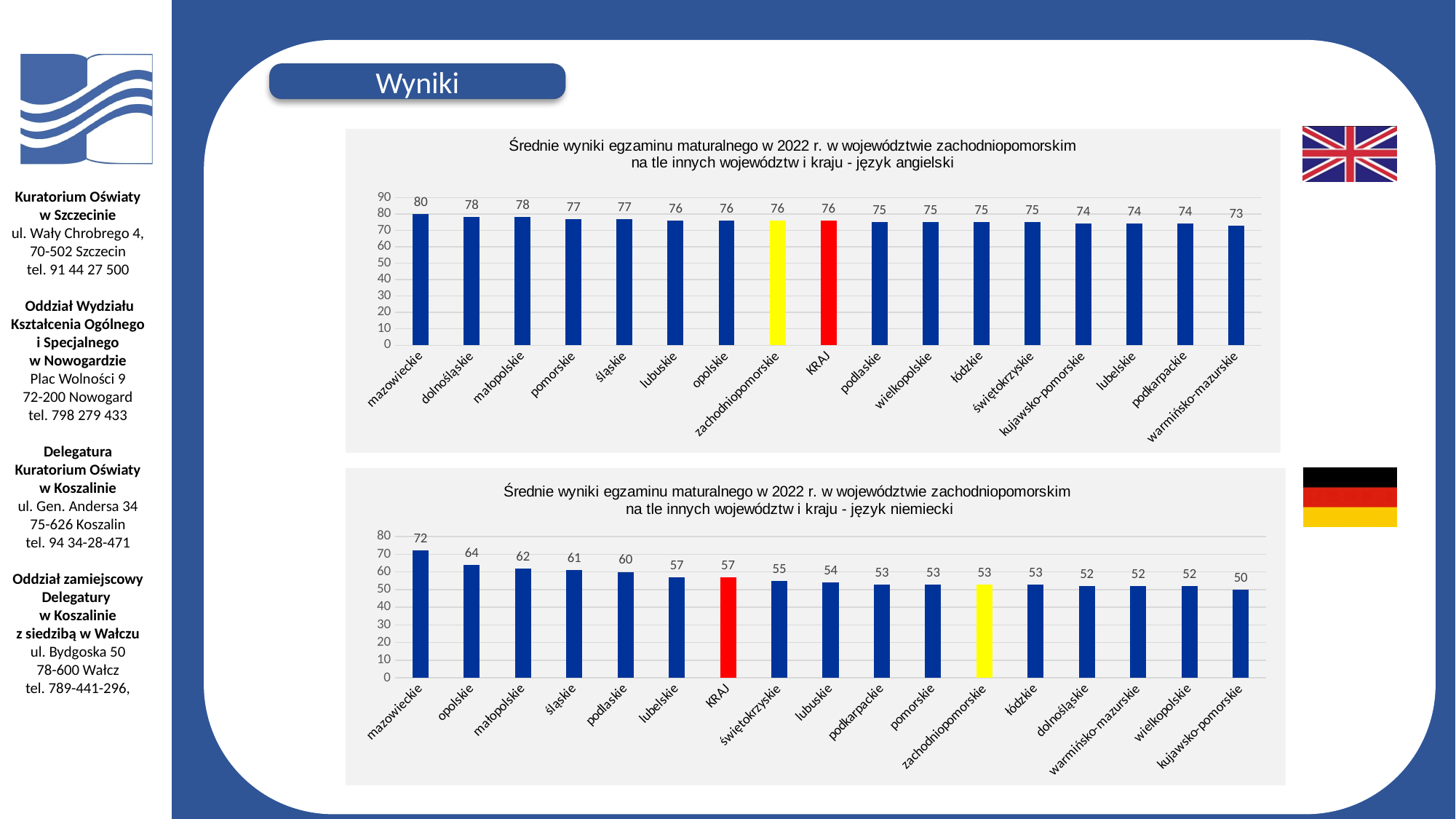
In the top chart (język angielski), what is the value for mazowieckie? 80 In the bottom chart (język niemiecki), what is the value for kujawsko-pomorskie? 50 In the top chart (język angielski), what is the difference between mazowieckie and warmińsko-mazurskie? 7 In the bottom chart (język niemiecki), what colour is the bar for zachodniopomorskie? yellow In the top chart (język angielski), what is the value for zachodniopomorskie? 76 In the bottom chart (język niemiecki), what is the value for KRAJ? 57 What kind of chart is the bottom chart (język niemiecki)? bar chart In the bottom chart (język niemiecki), which is larger, the value for opolskie or the value for lubelskie? opolskie In the bottom chart (język niemiecki), what is the difference between mazowieckie and opolskie? 8 In the top chart (język angielski), which category has the lowest value? warmińsko-mazurskie In the bottom chart (język niemiecki), which category has the highest value? mazowieckie In the top chart (język angielski), how many bars are plotted? 17